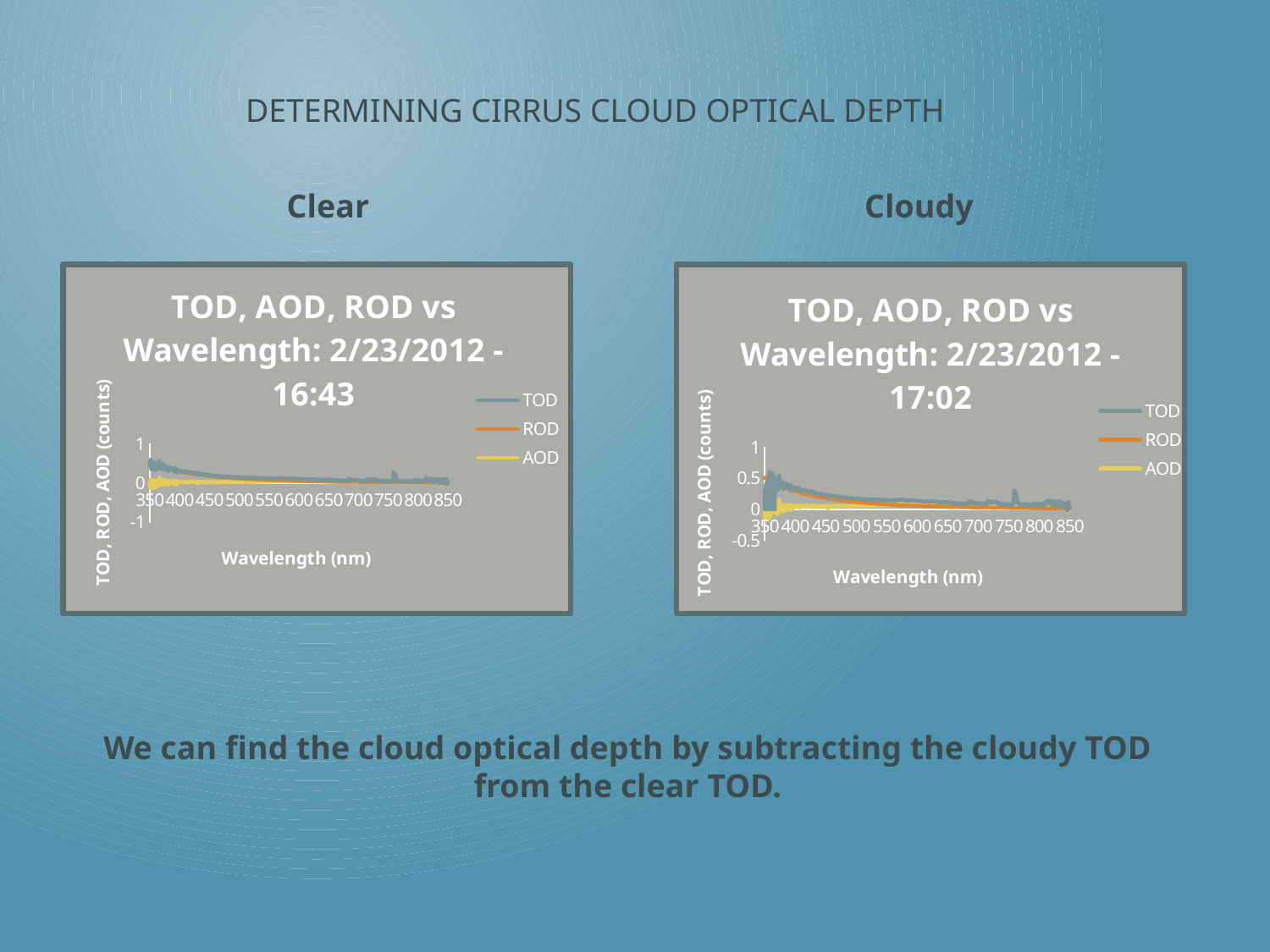
In the right chart (Cloudy), which series has the highest values around 400 nm? TOD In the right chart (Cloudy), is the TOD value at 800 nm greater or less than 0.5? less In the right chart (Cloudy), which is larger at 500 nm, TOD or AOD? TOD What is the x-axis title of the right chart (Cloudy)? Wavelength (nm) What kind of chart is the left chart titled 'TOD, AOD, ROD vs Wavelength: 2/23/2012 - 16:43'? line chart In the left chart (Clear), does the TOD series rise or fall as wavelength increases from 400 nm to 850 nm? fall What are the legend entries of the left chart (Clear)? TOD, ROD, AOD How many series does the legend of the right chart (Cloudy) list? 3 In the right chart (Cloudy), does the TOD series rise or fall as wavelength increases from 400 nm to 850 nm? fall How many tick labels are shown on the x axis of the left chart (Clear)? 11 In the left chart (Clear), is the TOD value at 800 nm greater or less than 1? less What time is given in the title of the right chart (Cloudy)? 17:02